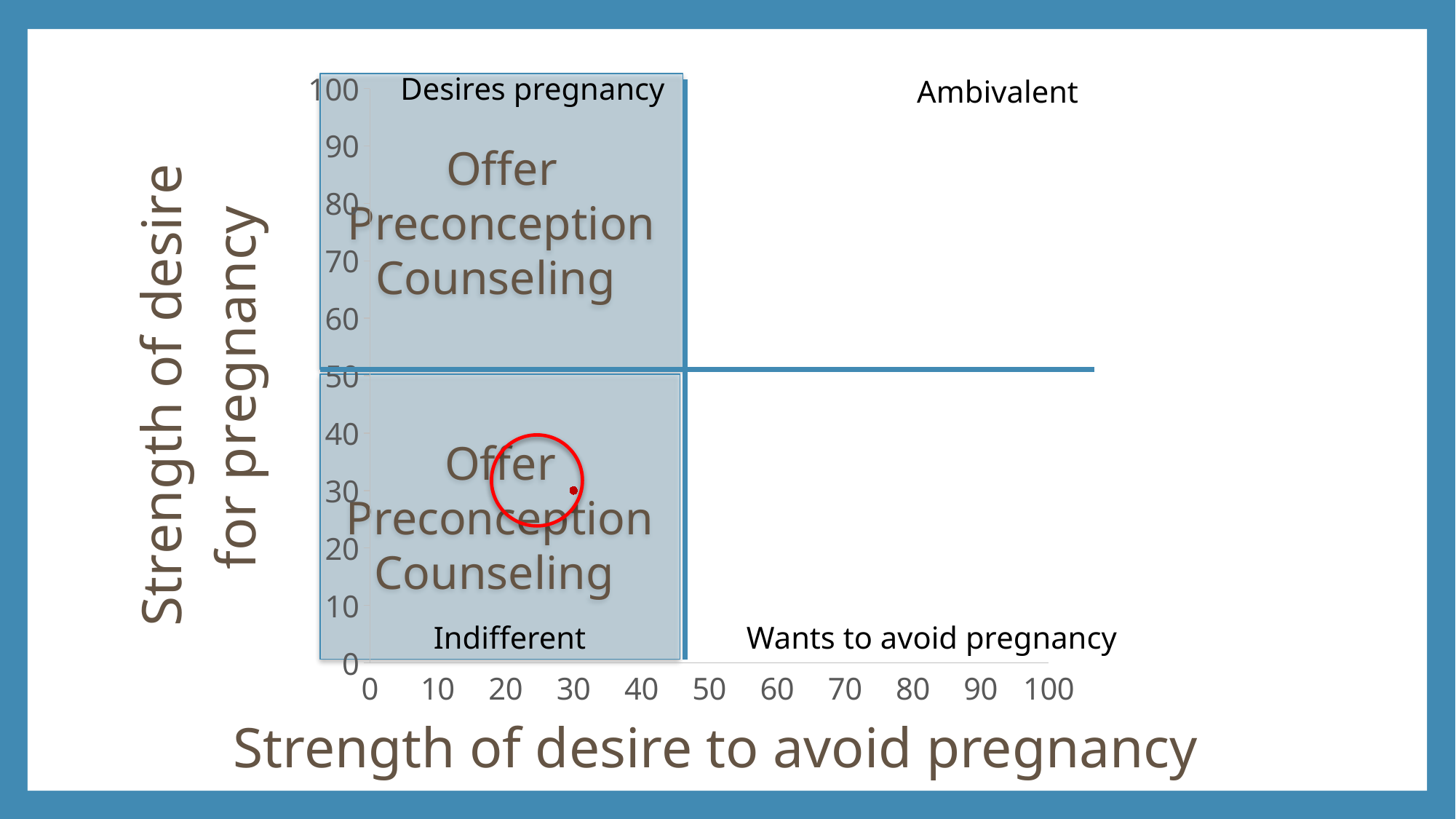
Is the x-axis value (strength of desire to avoid pregnancy) of the plotted point greater or less than 50? less Is the y-axis value of the plotted point greater or less than 20? greater What is the x-axis value of the plotted point? 30 What is the highest value shown on the y axis? 100 Is the y-axis value (strength of desire for pregnancy) of the plotted point greater or less than 50? less What is the title of the y axis? Strength of desire for pregnancy What is the title of the x axis? Strength of desire to avoid pregnancy Which labelled quadrant does the plotted point fall in? Indifferent What kind of chart is shown on the slide? scatter chart What is the y-axis value of the plotted point? 30 How many data points are plotted on the chart? 1